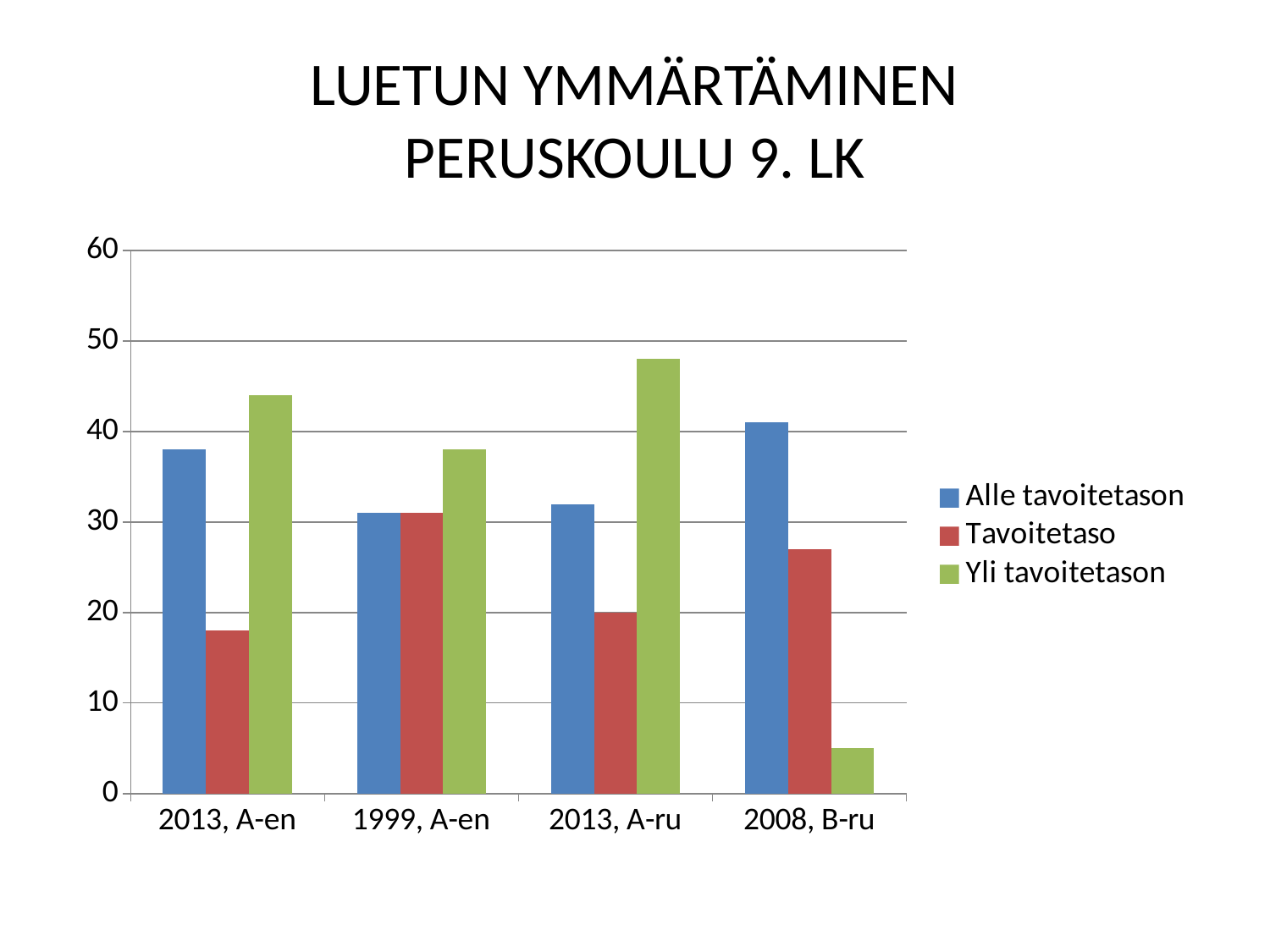
How many categories are shown on the x axis? 4 Is the value for Tavoitetaso in 2013, A-ru greater or less than 30? less In 2008, B-ru, which is larger: Alle tavoitetason or Tavoitetaso? Alle tavoitetason Is the value for Yli tavoitetason in 2013, A-ru greater or less than 40? greater Which category has the highest value for Alle tavoitetason? 2008, B-ru Which category has the lowest value for Yli tavoitetason? 2008, B-ru In 2013, A-en, which is larger: Alle tavoitetason or Yli tavoitetason? Yli tavoitetason Which series is shown in green in the legend? Yli tavoitetason Which category has the highest value for Yli tavoitetason? 2013, A-ru What kind of chart is shown on the slide? bar chart Is the value for Yli tavoitetason in 2008, B-ru greater or less than 10? less How many series does the legend list? 3